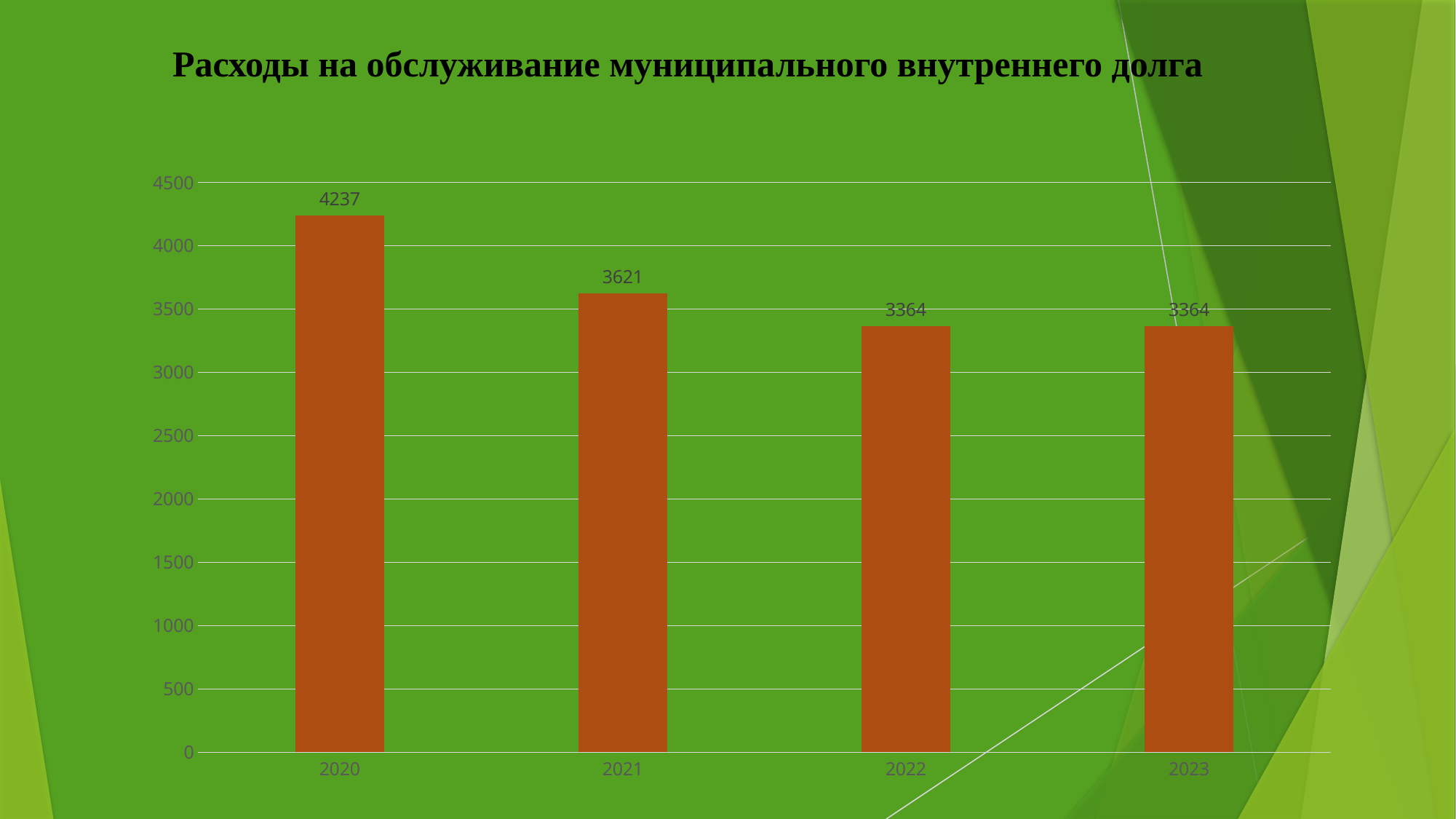
Is the value for 2021 greater or less than 3500? greater Which year has the highest value? 2020 What is the value for 2023? 3364 What is the difference between the values for 2021 and 2022? 257 What is the value for 2022? 3364 How many years are shown on the x axis? 4 What is the value for 2020? 4237 Which is larger, the value for 2020 or the value for 2021? 2020 What is the difference between the values for 2020 and 2021? 616 What is the title of the chart? Расходы на обслуживание муниципального внутреннего долга What is the value for 2021? 3621 What kind of chart is shown on the slide? bar chart